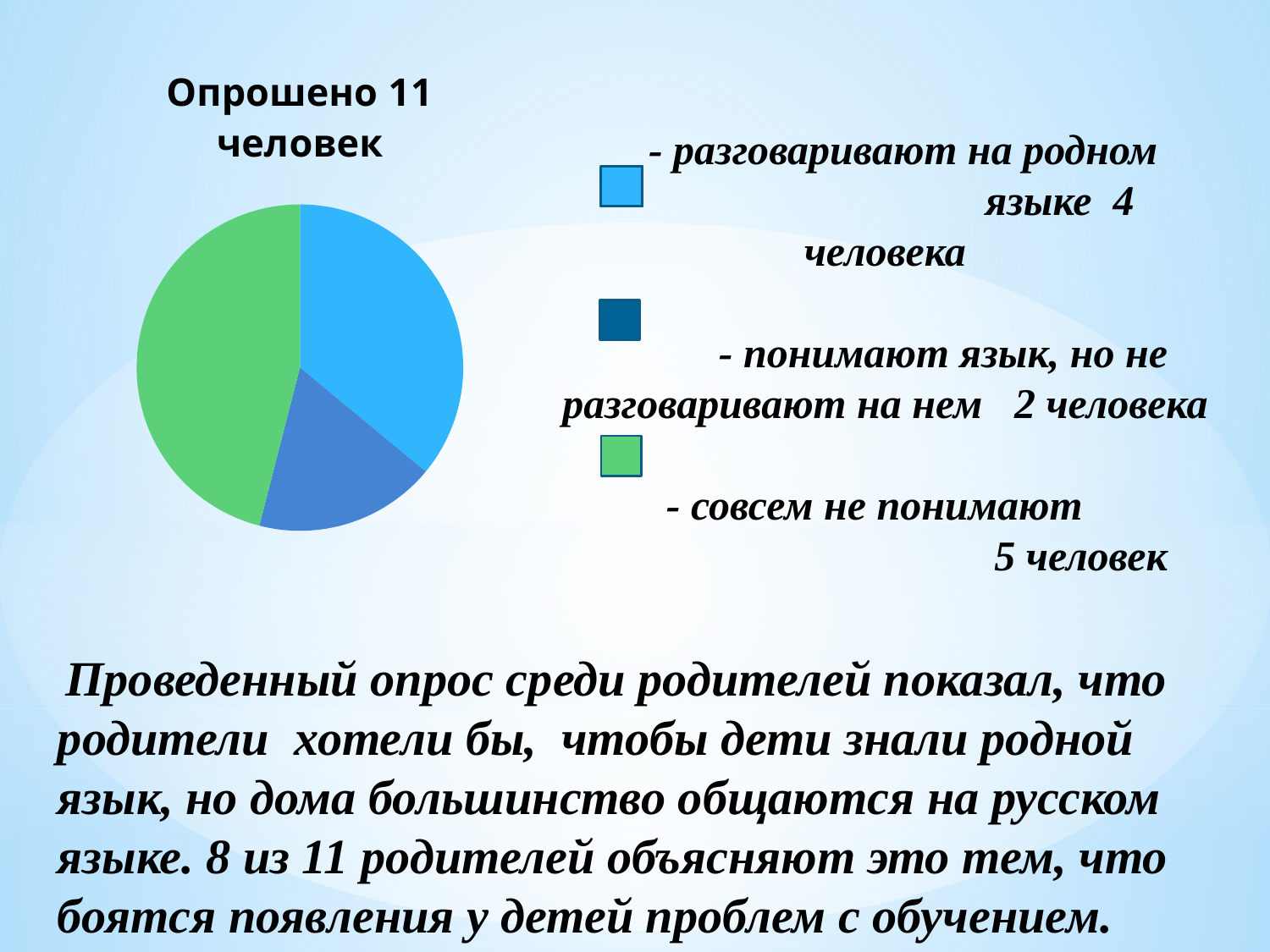
Какая категория имеет наибольшее значение на диаграмме? совсем не понимают Что больше: число тех, кто разговаривает на родном языке, или число тех, кто понимает язык, но не разговаривает на нем? разговаривают на родном языке Какая категория имеет наименьшее значение на диаграмме? понимают язык, но не разговаривают на нем Сколько человек было опрошено согласно заголовку диаграммы? 11 человек Какого типа диаграмма показана на слайде? круговая диаграмма На сколько человек больше разговаривают на родном языке, чем понимают язык, но не разговаривают на нем? 2 На сколько человек больше совсем не понимают язык, чем разговаривают на родном языке? 1 Каким цветом на диаграмме обозначена категория «совсем не понимают»? зелёным Сколько человек совсем не понимают язык? 5 человек Сколько категорий (секторов) показано на круговой диаграмме? 3 Сколько человек понимают язык, но не разговаривают на нем? 2 человека Сколько человек разговаривают на родном языке? 4 человека